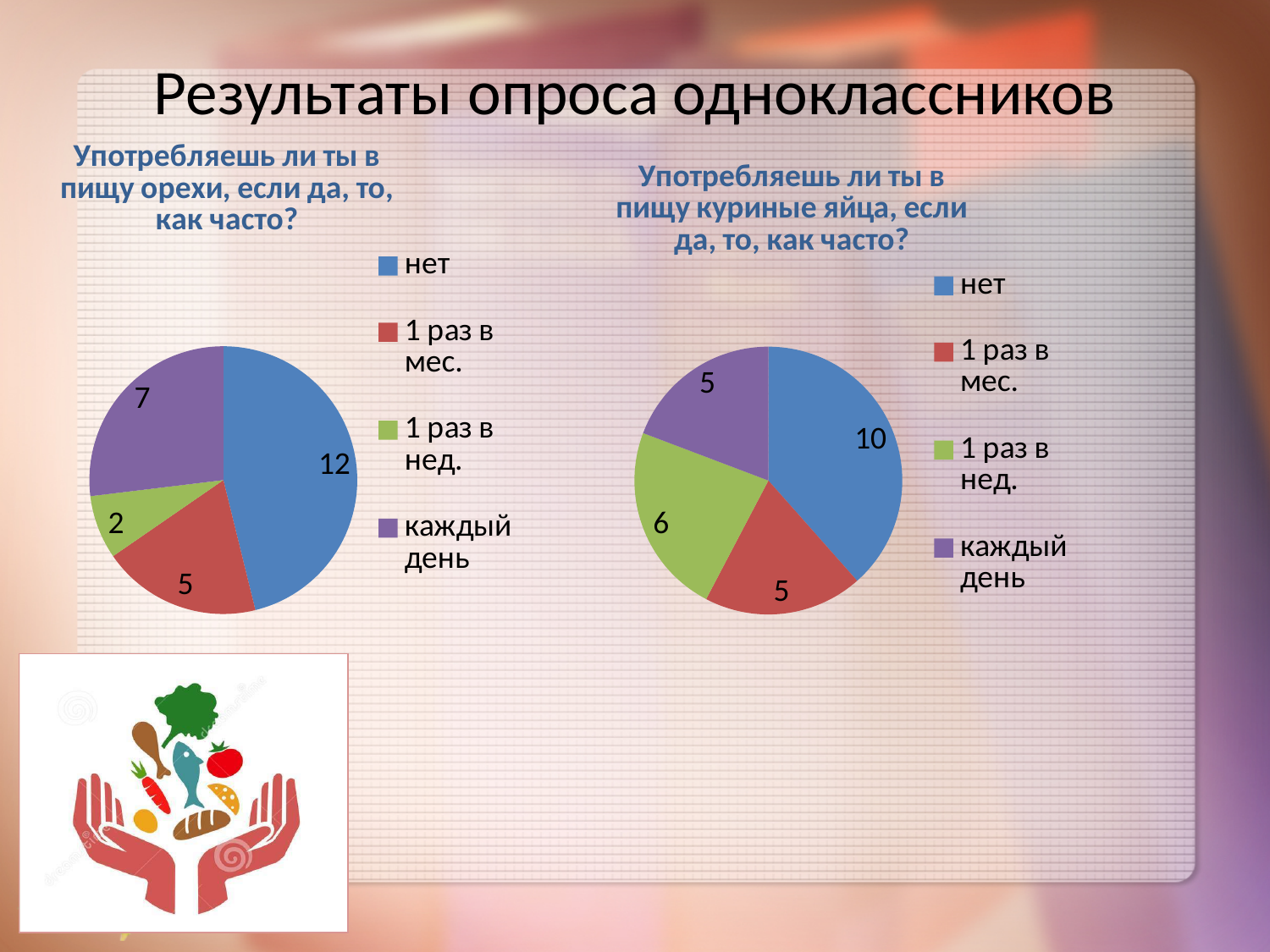
In the left pie chart about nuts (орехи), what is the value for "нет"? 12 Which is larger: the value for "каждый день" in the left chart about nuts or the value for "каждый день" in the right chart about eggs? the left chart (nuts) In the left pie chart about nuts (орехи), what is the value for "каждый день"? 7 In the right pie chart about chicken eggs (куриные яйца), what colour is the "1 раз в нед." slice? green In the right pie chart about chicken eggs (куриные яйца), what is the value for "нет"? 10 In the right pie chart about chicken eggs (куриные яйца), which category has the largest slice? нет In the right pie chart about chicken eggs (куриные яйца), what is the difference between the values for "нет" and "каждый день"? 5 In the right pie chart about chicken eggs (куриные яйца), what is the value for "1 раз в нед."? 6 What type of chart is used for the survey about chicken eggs (куриные яйца)? pie chart In the left pie chart about nuts (орехи), what is the difference between the values for "нет" and "1 раз в мес."? 7 In the left pie chart about nuts (орехи), which category has the smallest slice? 1 раз в нед. How many categories does the left pie chart about nuts (орехи) have? 4